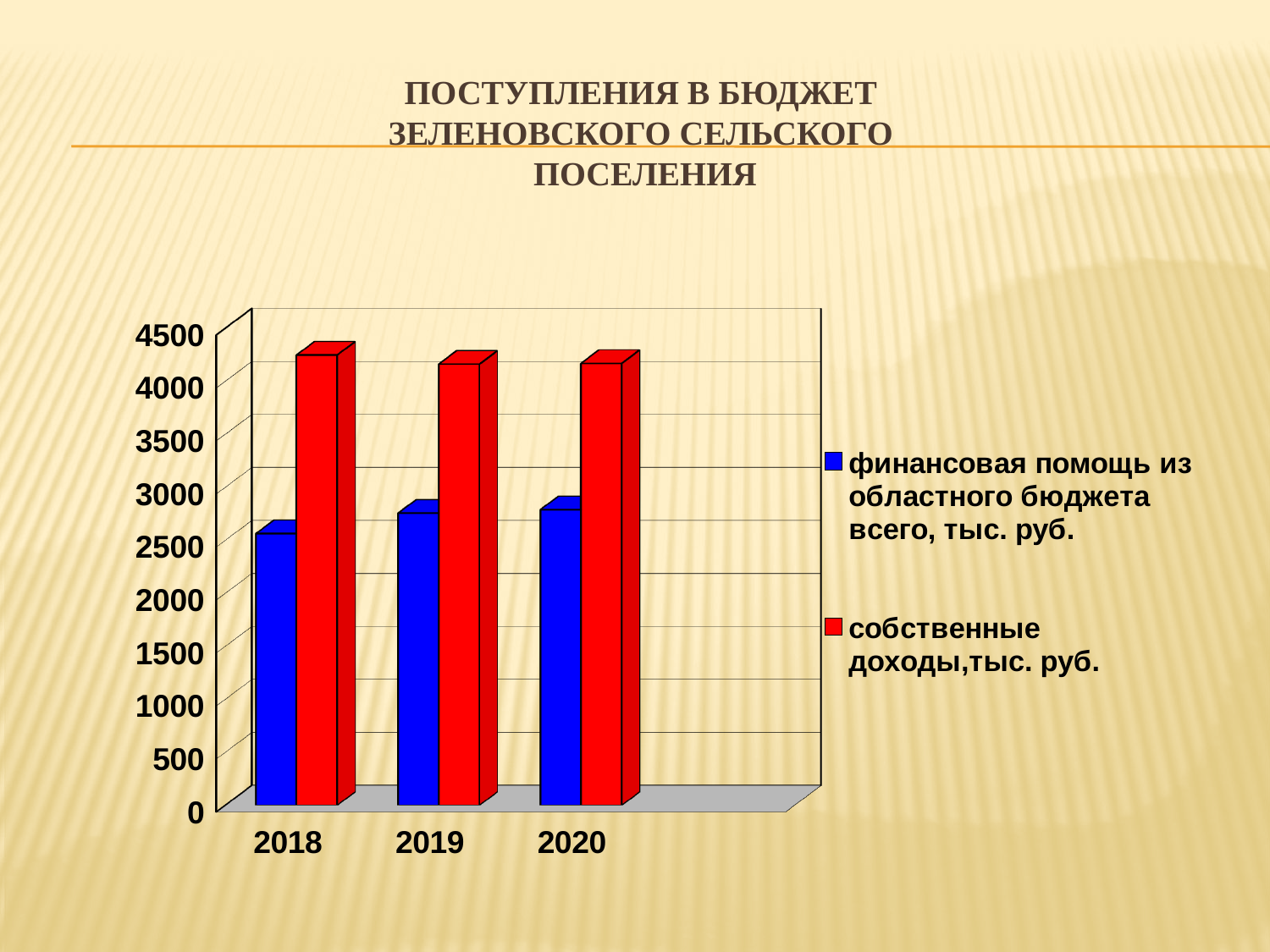
How many series does the chart legend list? 2 Is the value for финансовая помощь из областного бюджета in 2020 greater or less than 2500? greater How many years are shown on the x axis of the chart? 3 Is the value for финансовая помощь из областного бюджета in 2018 greater or less than 3000? less Which series is shown in red in the chart? собственные доходы,тыс. руб. Which series is shown in blue in the chart? финансовая помощь из областного бюджета всего, тыс. руб. In which year is финансовая помощь из областного бюджета the lowest? 2018 In 2018, which is larger: финансовая помощь из областного бюджета or собственные доходы? собственные доходы What kind of chart is shown on the slide? bar chart Is the value for собственные доходы in 2019 greater or less than 4500? less In 2020, which is larger: собственные доходы or финансовая помощь из областного бюджета? собственные доходы